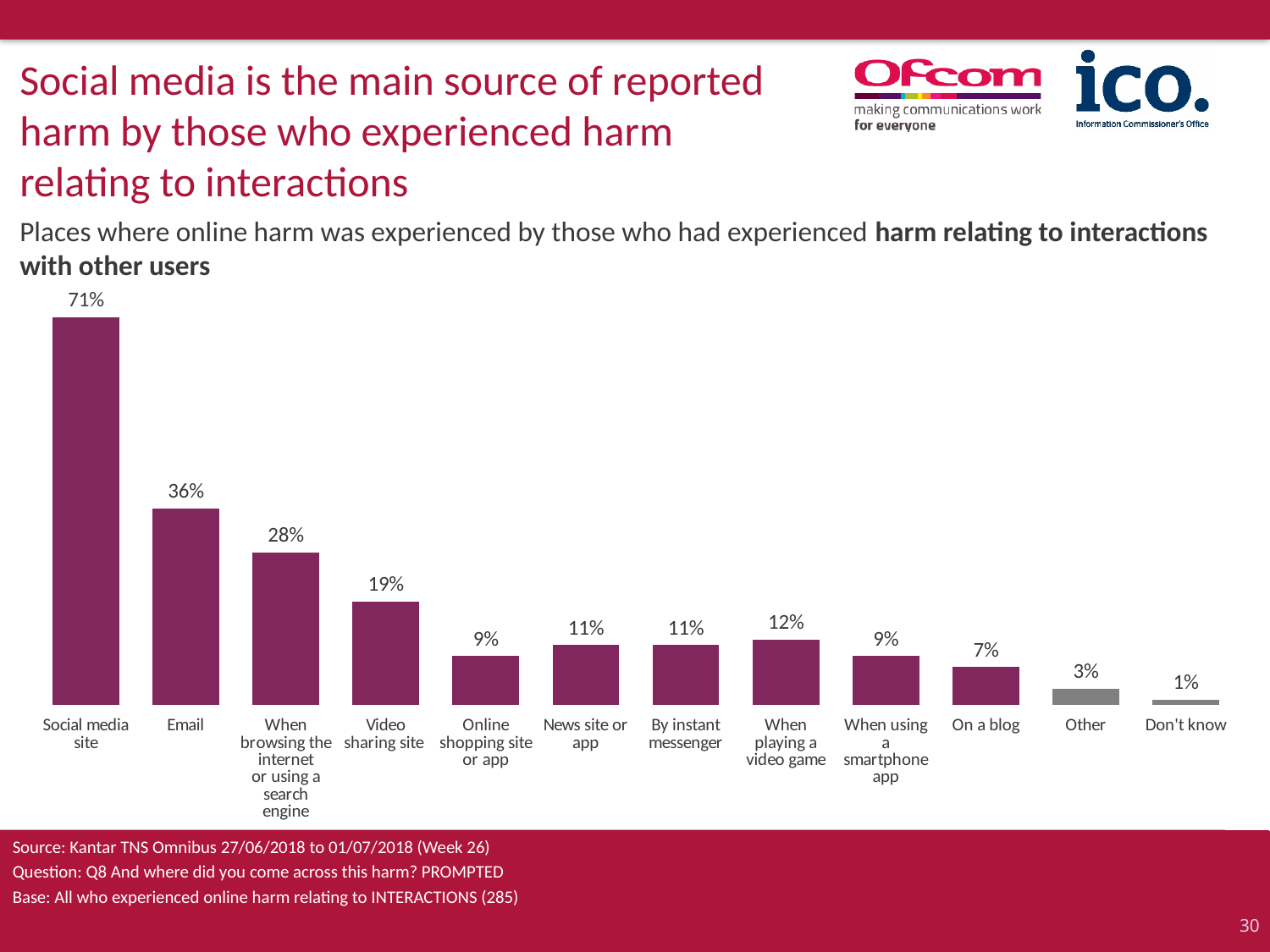
Which category has the highest value? Social media site What is the difference between the values for Video sharing site and Online shopping site or app? 10% Which category has the lowest value? Don't know What is the value shown for Email? 36% What is the difference between the values for Social media site and Email? 35% How many categories are shown in the chart? 12 Which two bars are shown in grey rather than purple? Other and Don't know What is the value for 'On a blog'? 7% What percentage is shown for 'When playing a video game'? 12% Which is larger, the value for Email or the value for 'When browsing the internet or using a search engine'? Email What percentage of respondents experienced harm on a social media site? 71% What kind of chart is shown on the slide? Bar chart